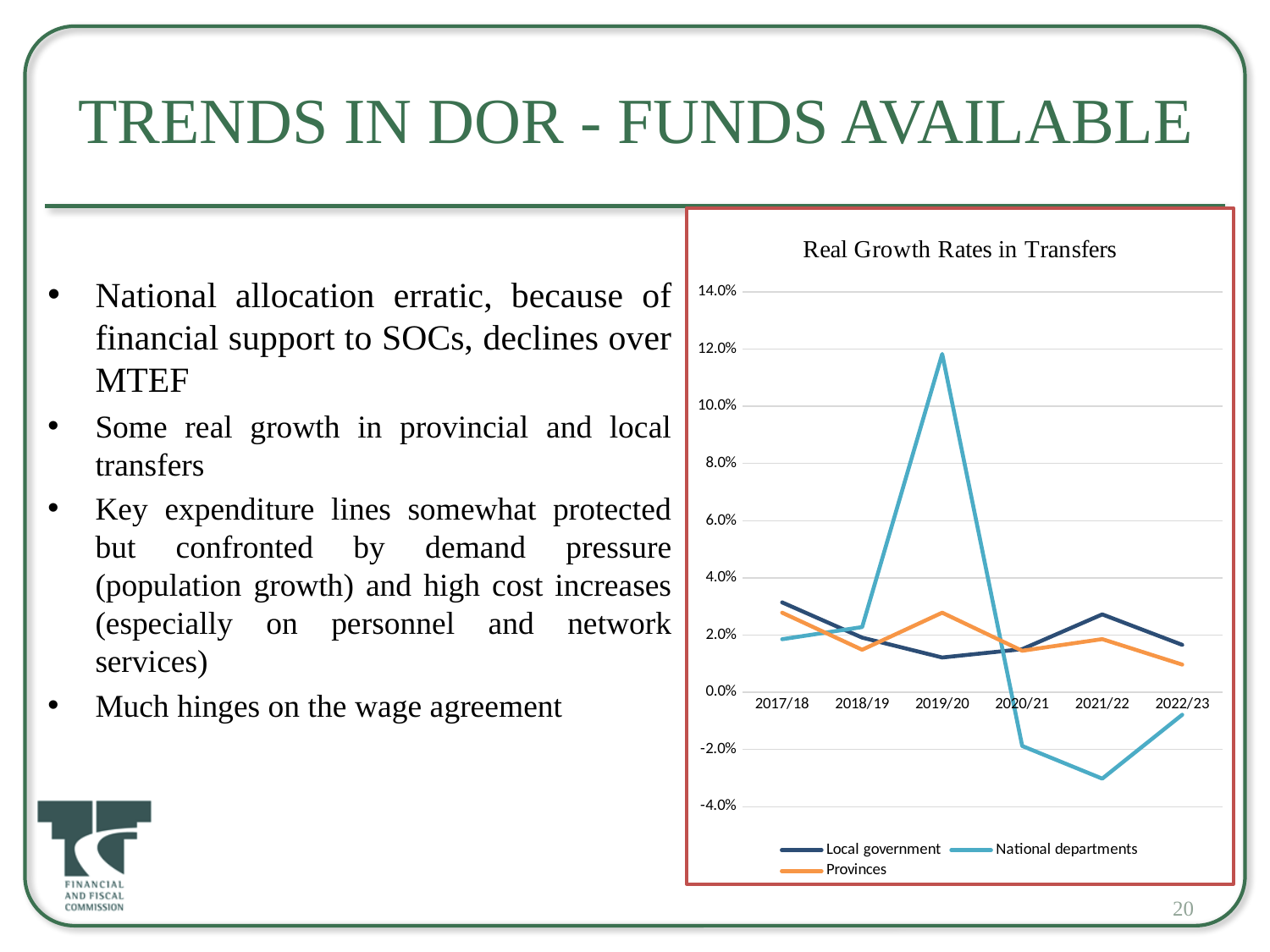
What kind of chart is shown on the slide? line chart Is the value for National departments in 2021/22 greater or less than -2.0%? less In 2019/20, which series has the larger value: National departments or Local government? National departments Is the value for National departments in 2019/20 greater or less than 10.0%? greater Is the value for Local government in 2017/18 greater or less than 2.0%? greater How many financial years are shown on the x axis of the chart? 6 In 2022/23, which series has the larger value: Local government or National departments? Local government How many series does the legend of the chart list? 3 Does the National departments series rise or fall from 2019/20 to 2021/22? fall In which year does the National departments series reach its highest value? 2019/20 In which year does the National departments series reach its lowest value? 2021/22 What is the title of the chart? Real Growth Rates in Transfers